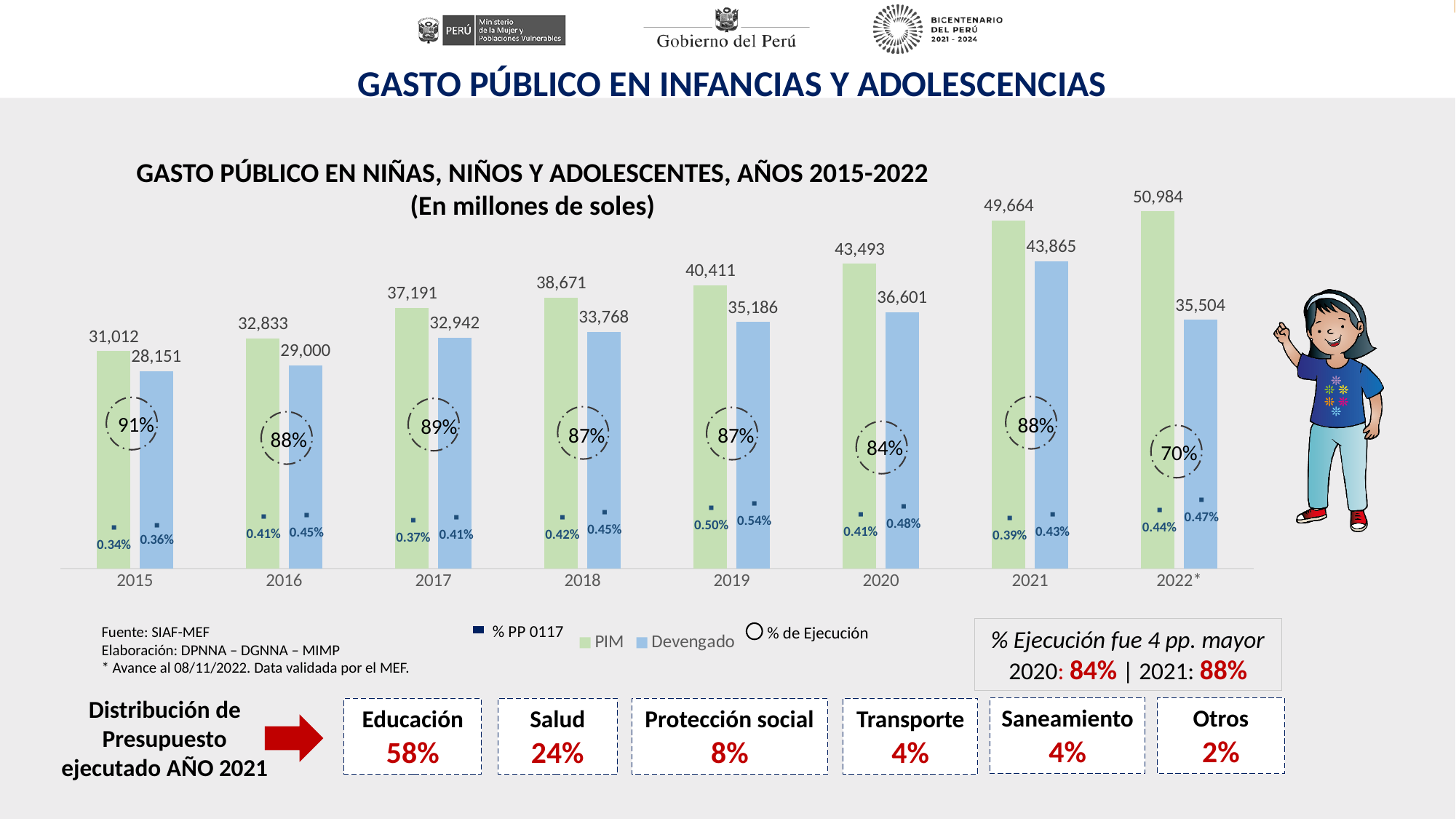
Which year has the lowest Devengado value? 2015 What is the PIM value for 2019? 40,411 What kind of chart is used to show PIM and Devengado? Bar chart Which year has the highest PIM value? 2022 How many entries does the chart legend list? 4 What is the % PP 0117 value shown on the Devengado bar for 2019? 0.54% What is the difference between the PIM and Devengado values for 2022? 15,480 Do the PIM values rise or fall from 2015 to 2022? Rise What is the Devengado value for 2021? 43,865 What is the % de Ejecución shown for 2020? 84% How many years are shown on the x axis of the chart? 8 Which is larger, the Devengado value for 2021 or the Devengado value for 2022? 2021